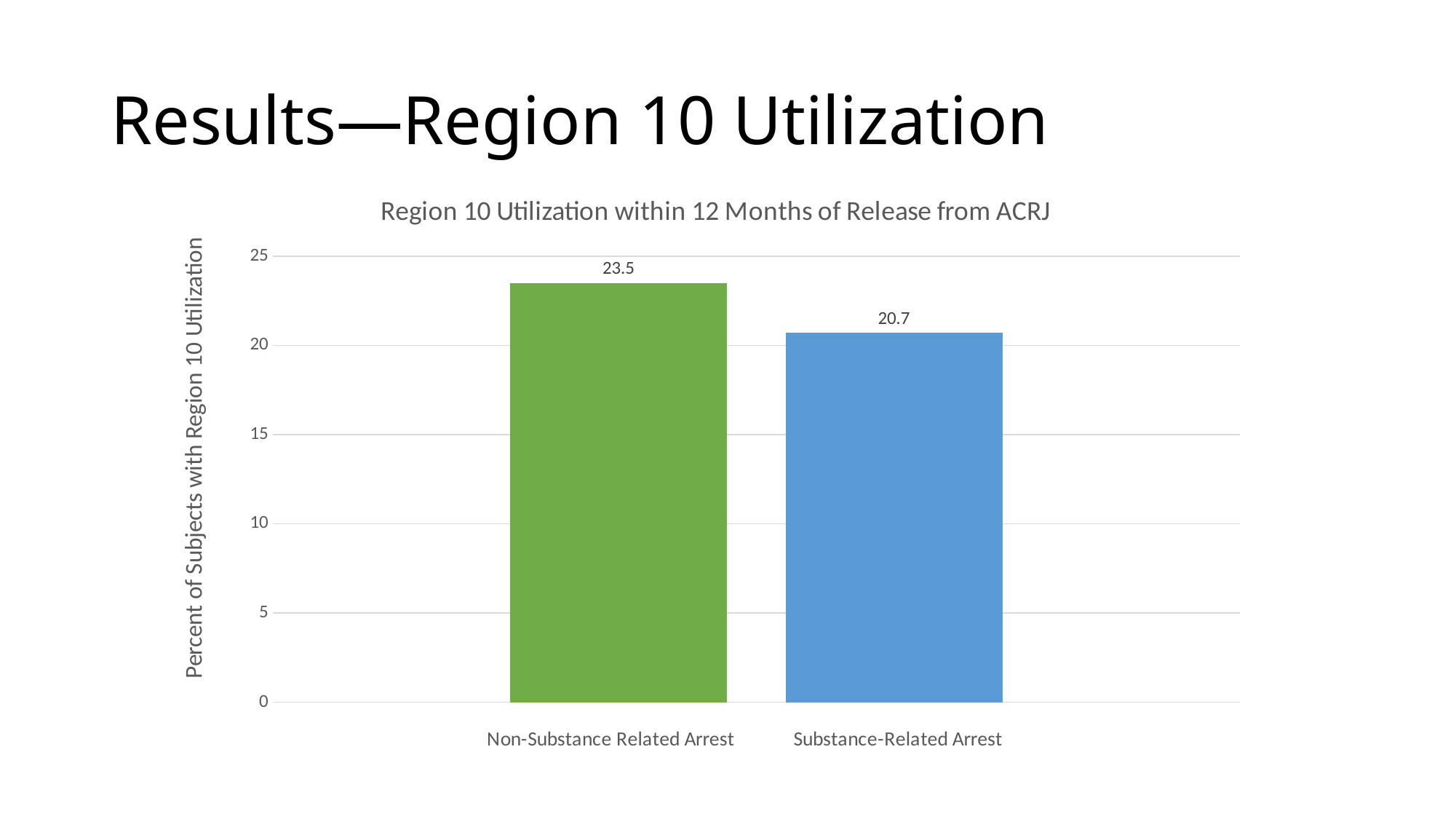
Is the value for Non-Substance Related Arrest greater or less than 20? greater What is the value for Non-Substance Related Arrest? 23.5 What kind of chart is shown on the slide? bar chart What is the label of the vertical axis? Percent of Subjects with Region 10 Utilization Which category has the highest value? Non-Substance Related Arrest What is the value for Substance-Related Arrest? 20.7 Is the value for Substance-Related Arrest greater or less than 25? less What is the difference between the values for Non-Substance Related Arrest and Substance-Related Arrest? 2.8 What is the title of the chart? Region 10 Utilization within 12 Months of Release from ACRJ Which is larger, the value for Non-Substance Related Arrest or the value for Substance-Related Arrest? Non-Substance Related Arrest Which category has the lowest value? Substance-Related Arrest How many categories are shown in the chart? 2